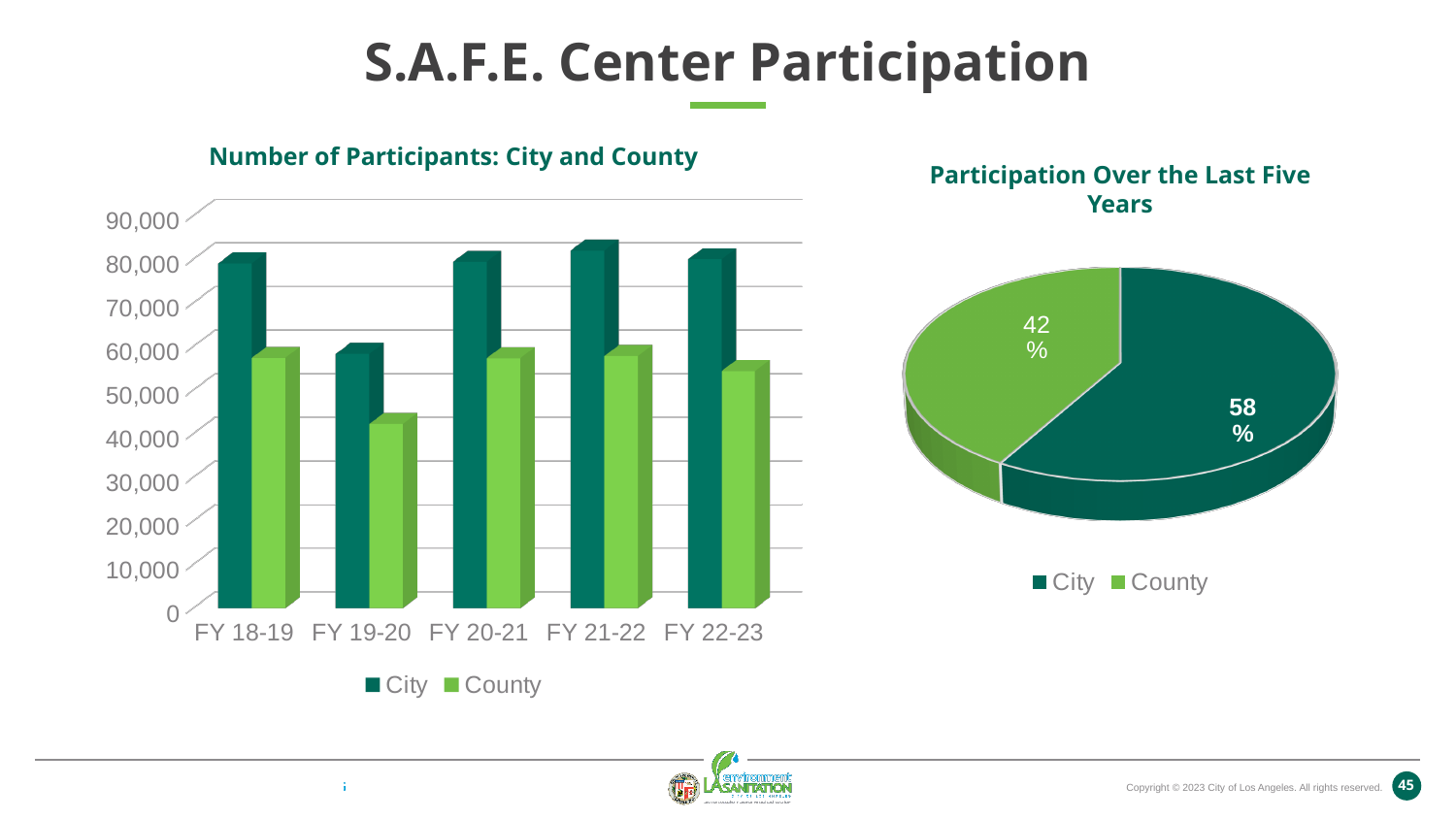
In the 'Number of Participants: City and County' chart, how many series does the legend list? 2 In the 'Number of Participants: City and County' chart, how many fiscal years are shown on the x axis? 5 In the 'Number of Participants: City and County' chart, which is larger in FY 20-21, City or County? City In the 'Number of Participants: City and County' chart, what kind of chart is it? bar chart In the 'Participation Over the Last Five Years' pie chart, what is the difference between the City and County shares? 16% In the 'Participation Over the Last Five Years' pie chart, what share does City have? 58% In the 'Participation Over the Last Five Years' pie chart, what share does County have? 42% In the 'Number of Participants: City and County' chart, is the County value for FY 19-20 greater or less than 50,000? less In the 'Number of Participants: City and County' chart, which fiscal year has the lowest County value? FY 19-20 In the 'Number of Participants: City and County' chart, which fiscal year has the lowest City value? FY 19-20 In the 'Number of Participants: City and County' chart, is the City value for FY 18-19 greater or less than 70,000? greater In the 'Number of Participants: City and County' chart, is the City value for FY 19-20 greater or less than 70,000? less